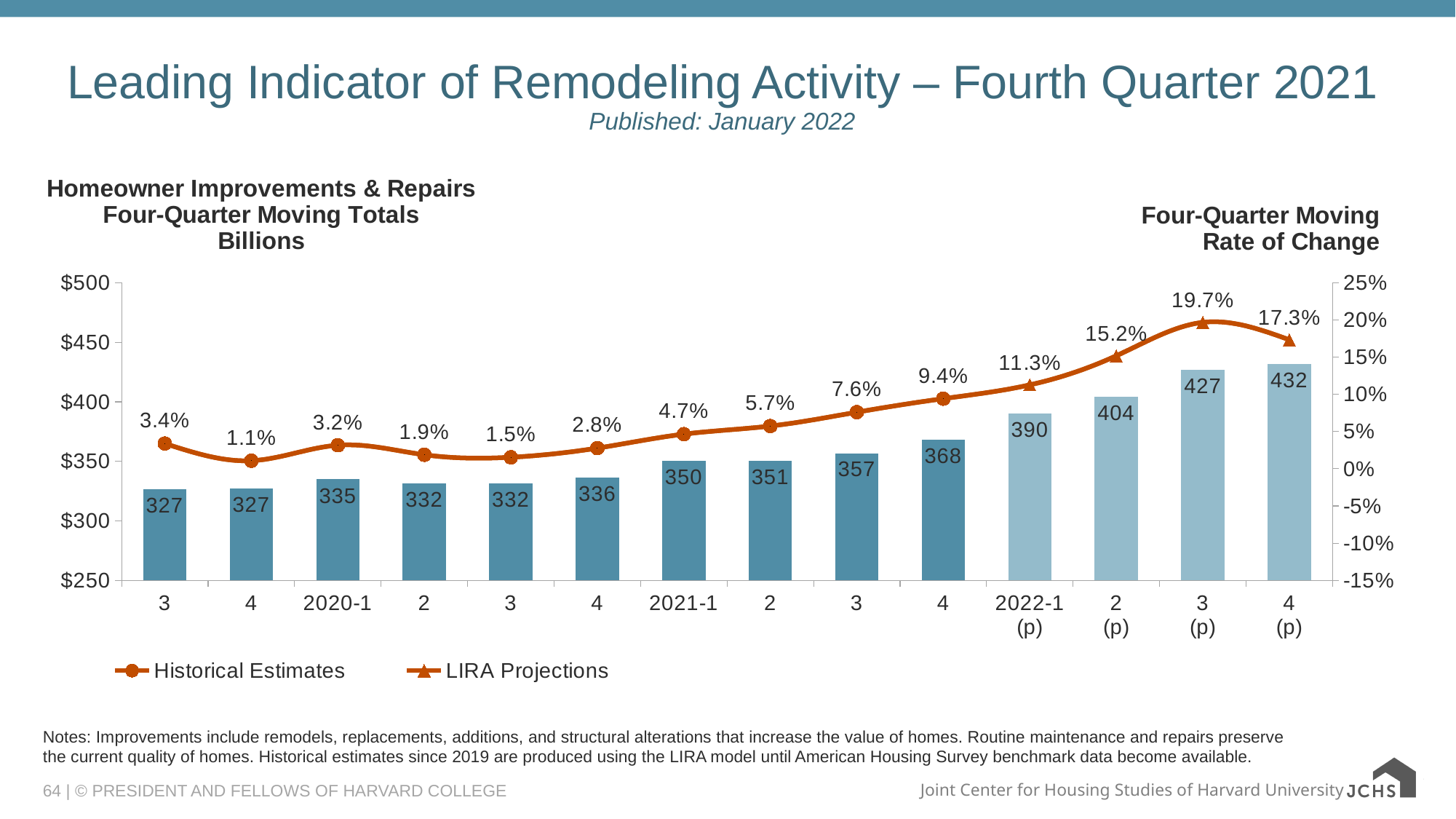
What is the four-quarter moving rate of change for 2022-3 (p)? 19.7% How many bars (quarters) are plotted in the chart? 14 Which quarter has the highest four-quarter moving rate of change? 2022-3 (p) Which is larger, the four-quarter moving total for 2020-1 or for 2020-3? 2020-1 What is the four-quarter moving total (in billions) for 2021-1? 350 What is the difference in four-quarter moving totals between 2022-4 (p) and 2021-4? 64 Do the four-quarter moving totals rise or fall from 2021-1 to 2022-4 (p)? Rise What is the four-quarter moving total (in billions) for 2022-4 (p)? 432 Which quarter has the lowest four-quarter moving rate of change? 2019-4 How many series does the legend list? 2 What are the two legend entries for the line series? Historical Estimates and LIRA Projections What kind of chart is shown on the slide? Combined bar and line chart